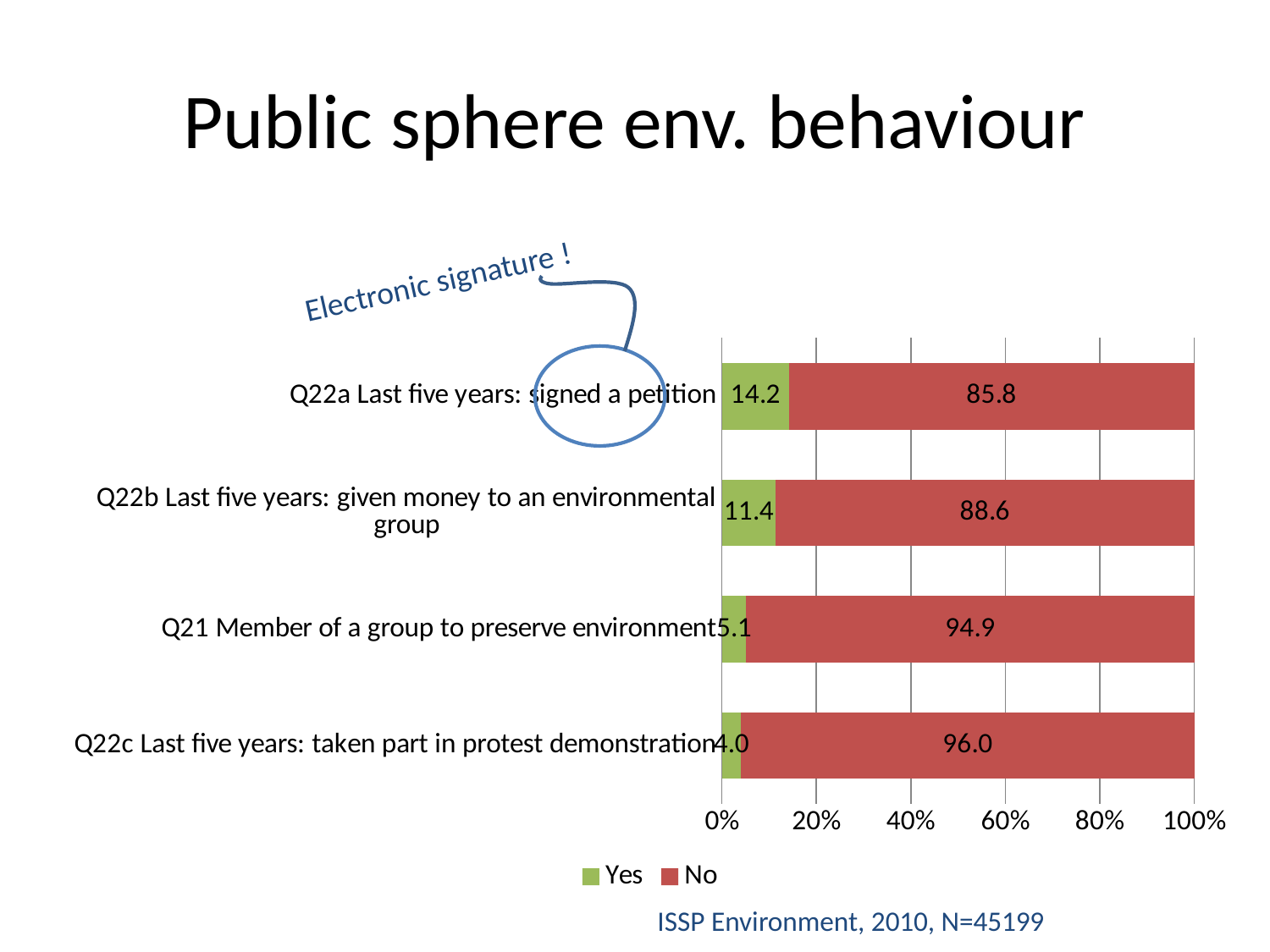
What is the total of the stacked bar for 'Q22b Last five years: given money to an environmental group'? 100.0 Which is larger: the 'No' value for 'Q21 Member of a group to preserve environment' or the 'No' value for 'Q22a Last five years: signed a petition'? Q21 Member of a group to preserve environment Which category has the highest 'Yes' value? Q22a Last five years: signed a petition What is the 'Yes' value for 'Q21 Member of a group to preserve environment'? 5.1 What is the 'No' value for 'Q22c Last five years: taken part in protest demonstration'? 96.0 What is the 'Yes' value for 'Q22a Last five years: signed a petition'? 14.2 How many series does the legend list? 2 What is the difference between the 'Yes' values for 'Q22a Last five years: signed a petition' and 'Q22b Last five years: given money to an environmental group'? 2.8 Which category has the lowest 'Yes' value? Q22c Last five years: taken part in protest demonstration What kind of chart is shown on the slide? Stacked bar chart How many categories are shown in the chart? 4 What is the 'No' value for 'Q22b Last five years: given money to an environmental group'? 88.6